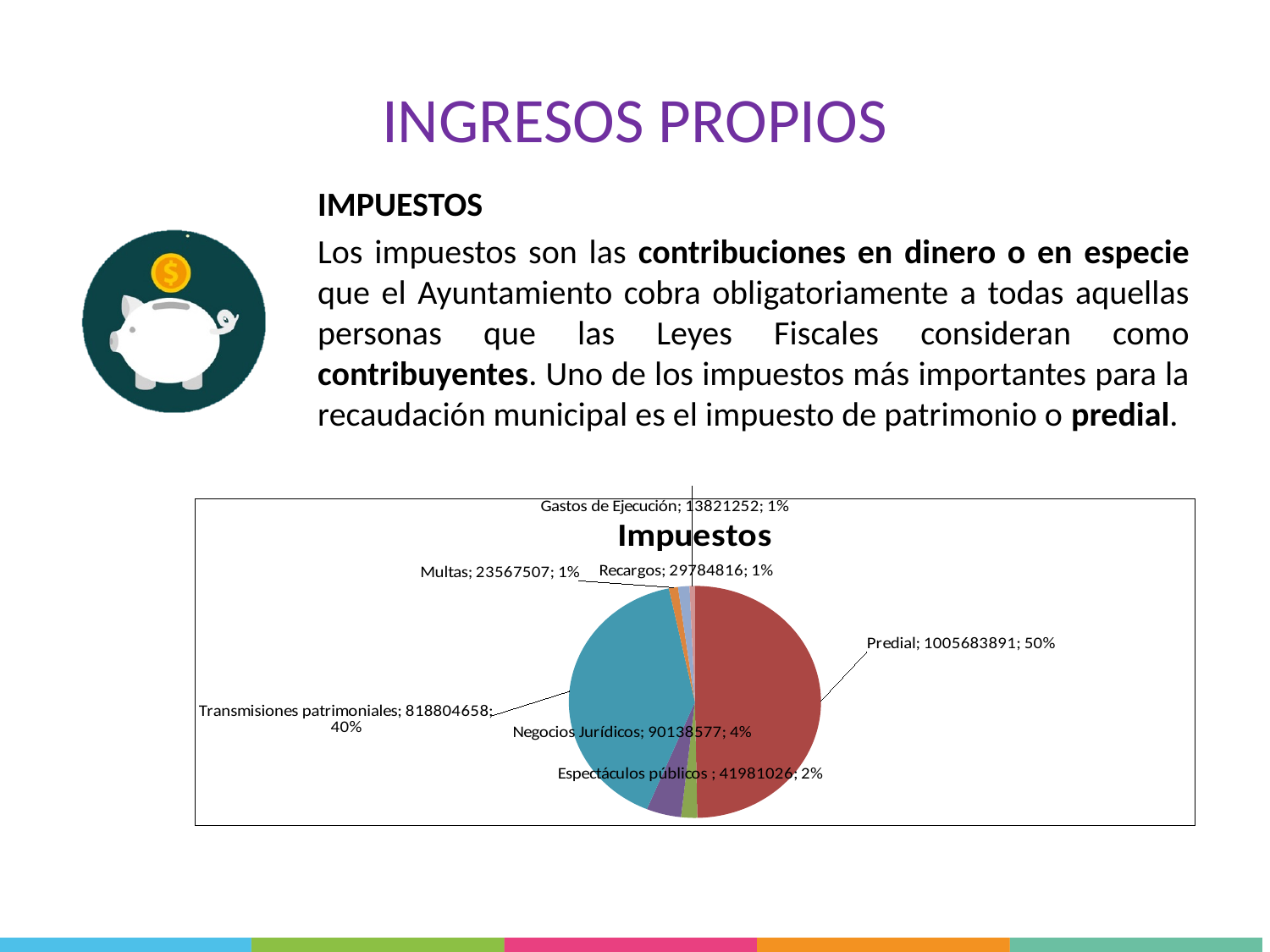
Which is larger, Recargos or Multas? Recargos What is the title of the chart? Impuestos Which category has the smallest slice? Gastos de Ejecución What share of the pie does Espectáculos públicos represent? 2% Which category has the largest slice? Predial What is the value for Multas? 23567507 What type of chart is shown on the slide? pie chart What is the value for Negocios Jurídicos? 90138577 How many slices does the pie chart have? 7 What is the value for Transmisiones patrimoniales? 818804658 What share of the pie does Transmisiones patrimoniales represent? 40% What is the value for Predial? 1005683891